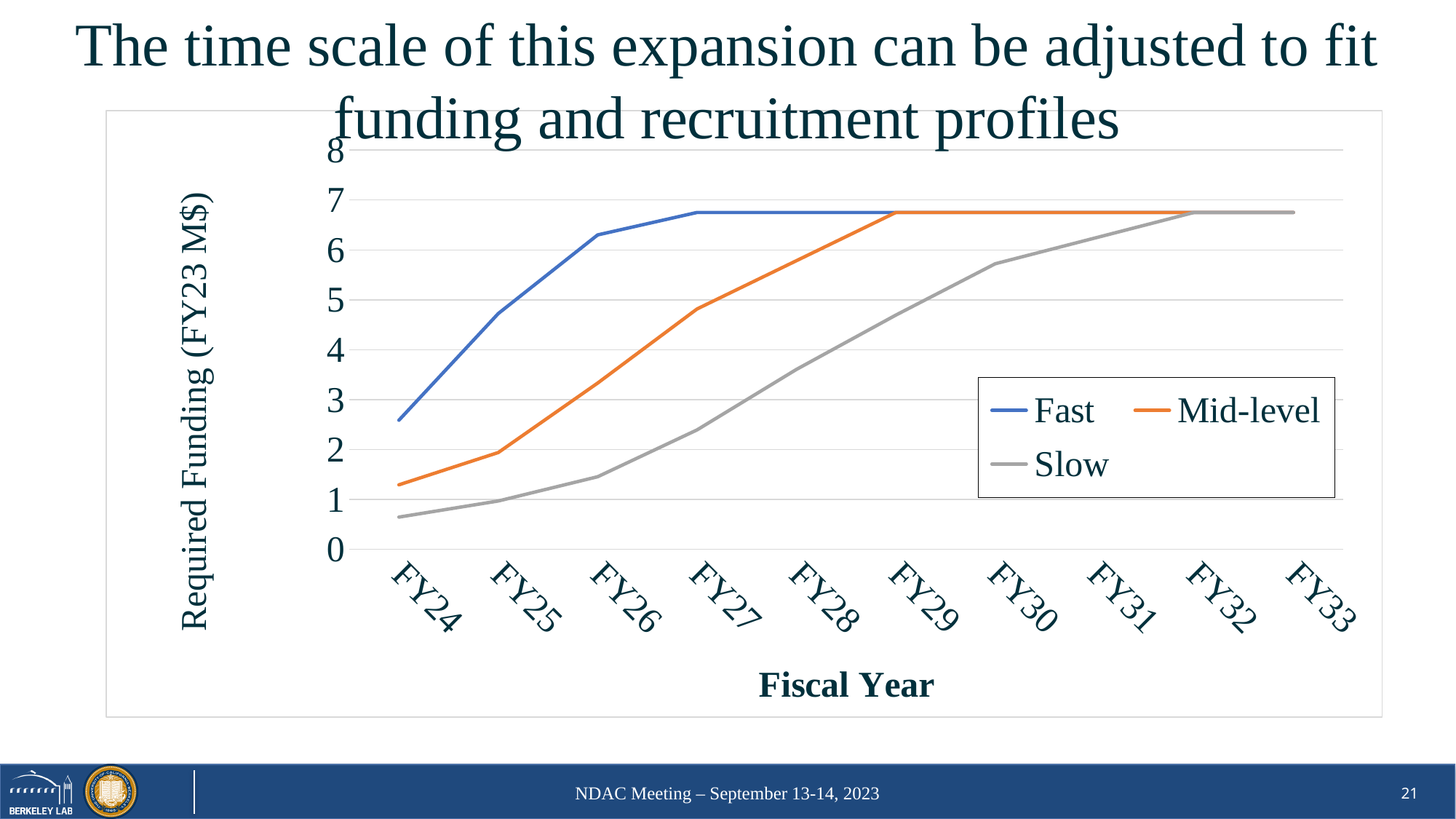
Is the value for Slow in FY24 greater or less than 1? less What kind of chart is shown on the slide? line chart How many series does the legend list? 3 Is the value for Fast in FY24 greater or less than 2? greater Which series has the lowest value in FY27? Slow Does the Slow series rise or fall from FY24 to FY33? rise What is the y-axis label of the chart? Required Funding (FY23 M$) Is the value for Slow in FY30 greater or less than 5? greater Which series has the highest value in FY25? Fast How many fiscal years are shown on the x axis? 10 Which series is drawn in orange? Mid-level